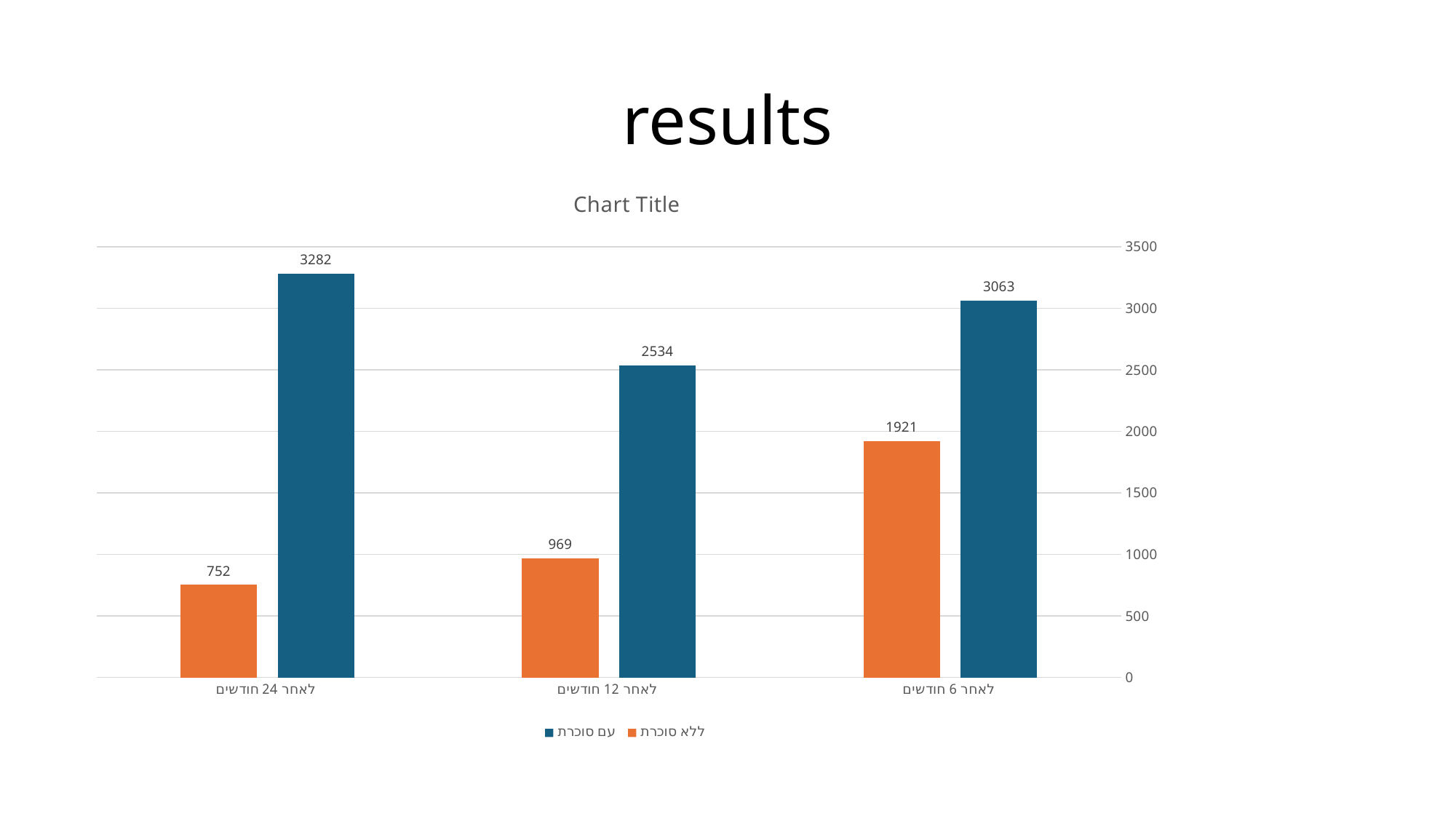
Which category has the lowest value for the ללא סוכרת series? לאחר 24 חודשים Is the value for ללא סוכרת at לאחר 24 חודשים greater or less than 1000? less What is the value for ללא סוכרת at לאחר 12 חודשים? 969 What kind of chart is shown on the slide? bar chart What is the value for ללא סוכרת at לאחר 6 חודשים? 1921 How many categories are shown on the x axis? 3 How many series does the legend list? 2 Which category has the highest value for the עם סוכרת series? לאחר 24 חודשים Which is larger at לאחר 12 חודשים: עם סוכרת or ללא סוכרת? עם סוכרת What is the value for עם סוכרת at לאחר 12 חודשים? 2534 What is the difference between the עם סוכרת and ללא סוכרת values at לאחר 6 חודשים? 1142 What is the value for עם סוכרת at לאחר 24 חודשים? 3282